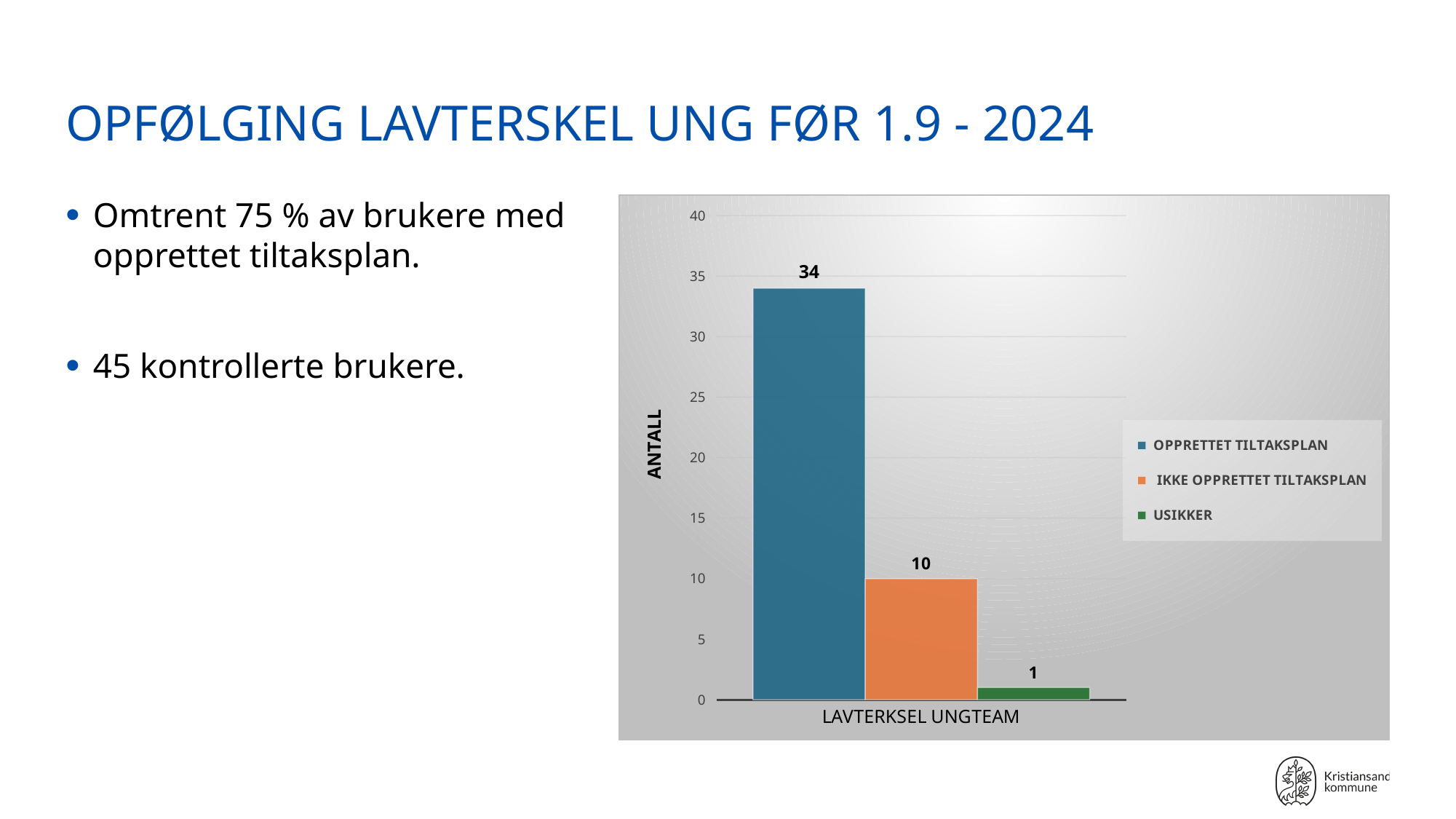
What is the value for USIKKER? 1 What is the value for OPPRETTET TILTAKSPLAN? 34 What is the difference between OPPRETTET TILTAKSPLAN and IKKE OPPRETTET TILTAKSPLAN? 24 What kind of chart is shown on the slide? bar chart What is the label on the vertical axis of the chart? ANTALL Which is larger, IKKE OPPRETTET TILTAKSPLAN or USIKKER? IKKE OPPRETTET TILTAKSPLAN What is the category label on the horizontal axis of the chart? LAVTERKSEL UNGTEAM How many series does the legend list? 3 What is the value for IKKE OPPRETTET TILTAKSPLAN? 10 Which series has the highest value? OPPRETTET TILTAKSPLAN Which series has the lowest value? USIKKER Is the value for OPPRETTET TILTAKSPLAN greater or less than 30? greater